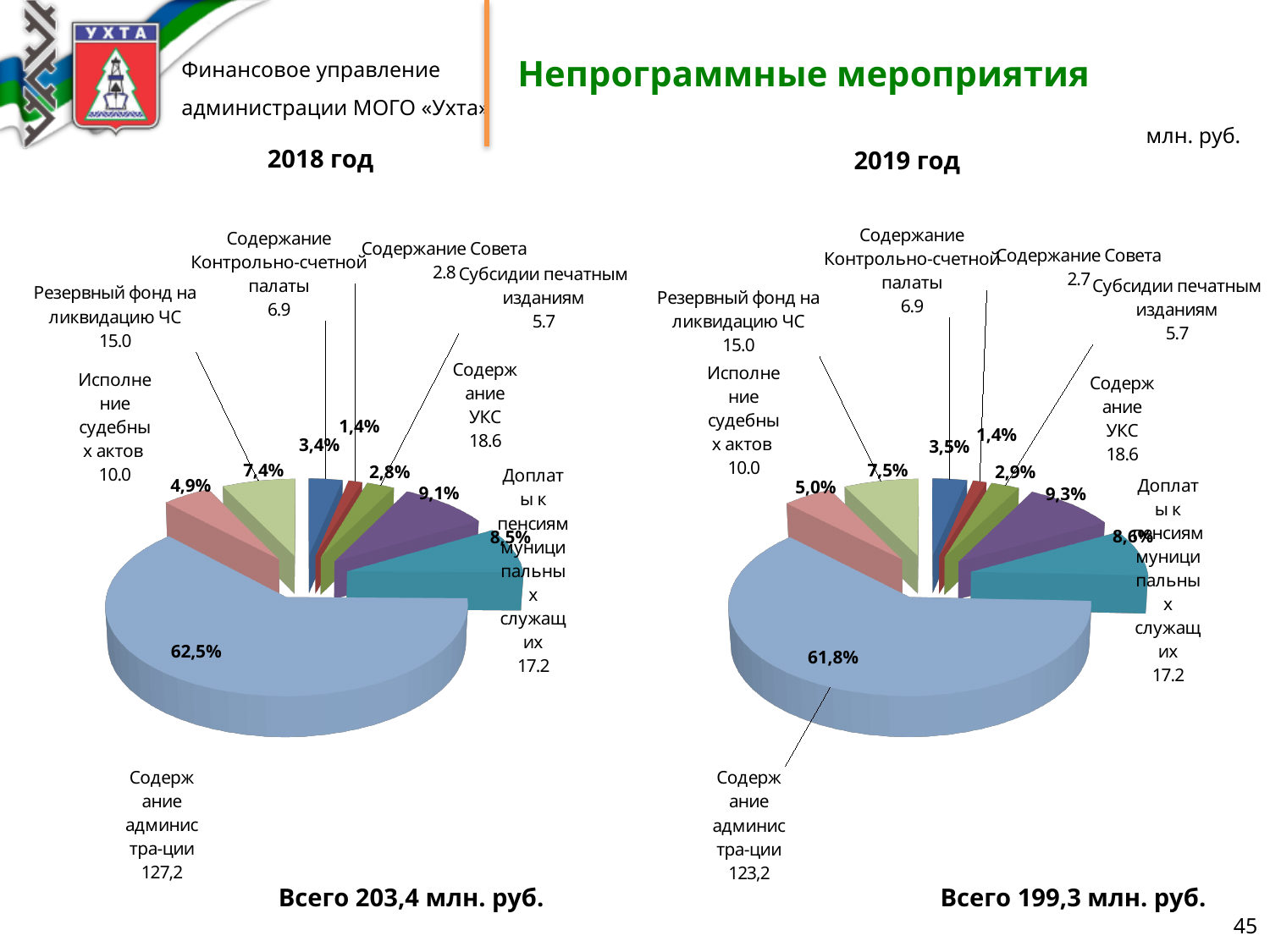
In the 2018 год chart, which is larger: Содержание УКС or Доплаты к пенсиям муниципальных служащих? Содержание УКС In the 2019 год chart, what percentage share does Содержание УКС have? 9,3% In the 2018 год chart, which category has the smallest slice? Содержание Совета In the 2019 год chart, which category has the largest slice? Содержание администрации In the 2018 год chart, what value is shown for Содержание администрации? 127,2 In the 2019 год chart, what value is shown for Содержание администрации? 123,2 In the 2019 год chart, what value is shown for Содержание Совета? 2.7 How many categories does the 2019 год chart show? 8 What is the difference between the Содержание администрации values in the 2018 год and 2019 год charts? 4,0 In the 2018 год chart, what value is shown for Резервный фонд на ликвидацию ЧС? 15.0 What type of chart is used for the 2018 год data? Pie chart In the 2018 год chart, what percentage share does Содержание администрации have? 62,5%